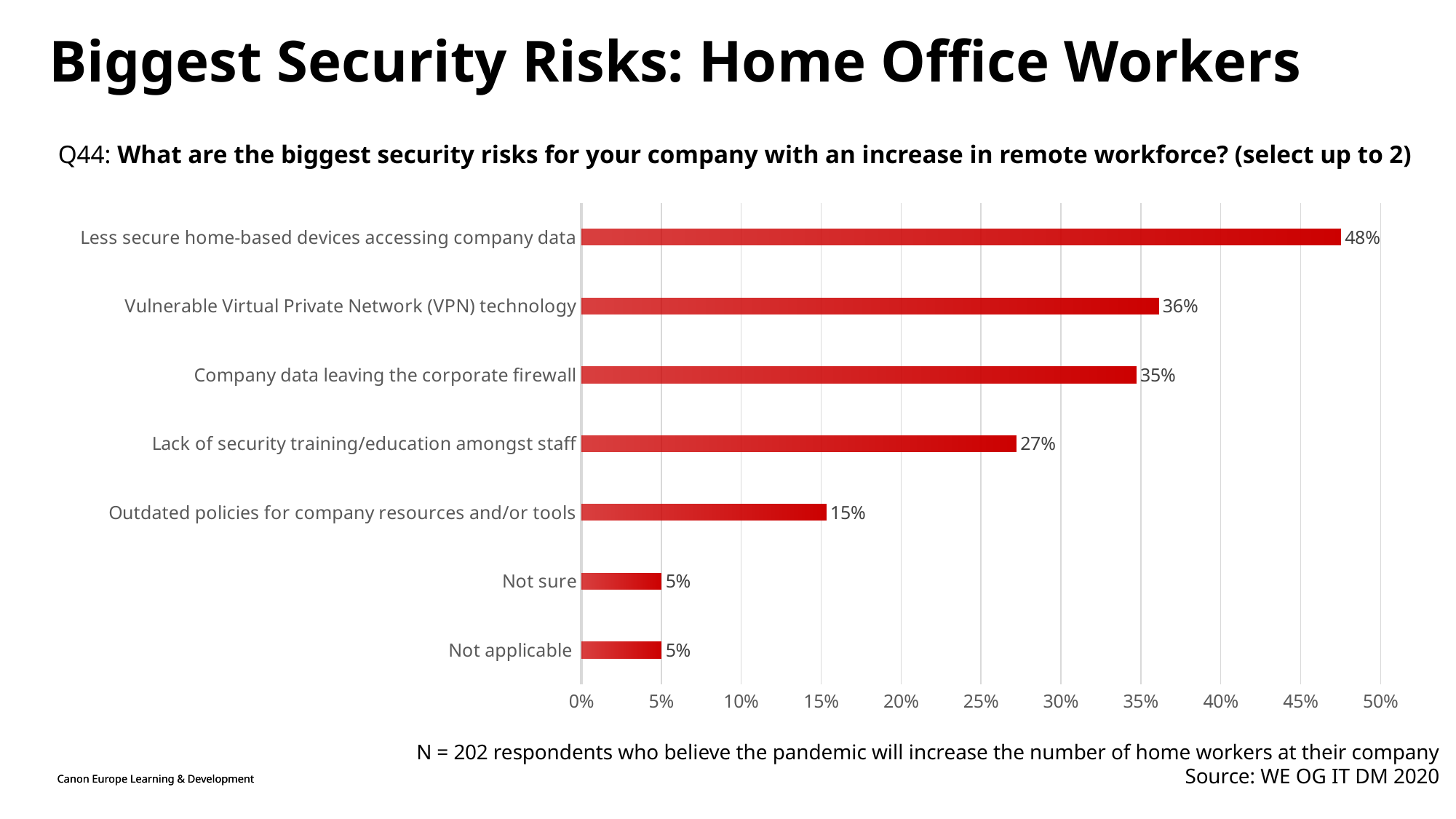
What percentage is shown for "Outdated policies for company resources and/or tools"? 15% What percentage of respondents selected "Less secure home-based devices accessing company data"? 48% Which security risk has the highest percentage? Less secure home-based devices accessing company data Which is larger: "Company data leaving the corporate firewall" or "Lack of security training/education amongst staff"? Company data leaving the corporate firewall How many categories are shown in the chart? 7 What is the value for "Vulnerable Virtual Private Network (VPN) technology"? 36% What type of chart is shown on the slide? Bar chart What is the maximum value shown on the horizontal axis? 50% What is the difference between "Lack of security training/education amongst staff" and "Outdated policies for company resources and/or tools"? 12 percentage points What is the difference in percentage points between "Less secure home-based devices accessing company data" and "Vulnerable Virtual Private Network (VPN) technology"? 12 percentage points Which category has the lowest value other than the two tied at 5%? Name the category with 15%. Outdated policies for company resources and/or tools Is the value for "Lack of security training/education amongst staff" greater or less than 25%? greater